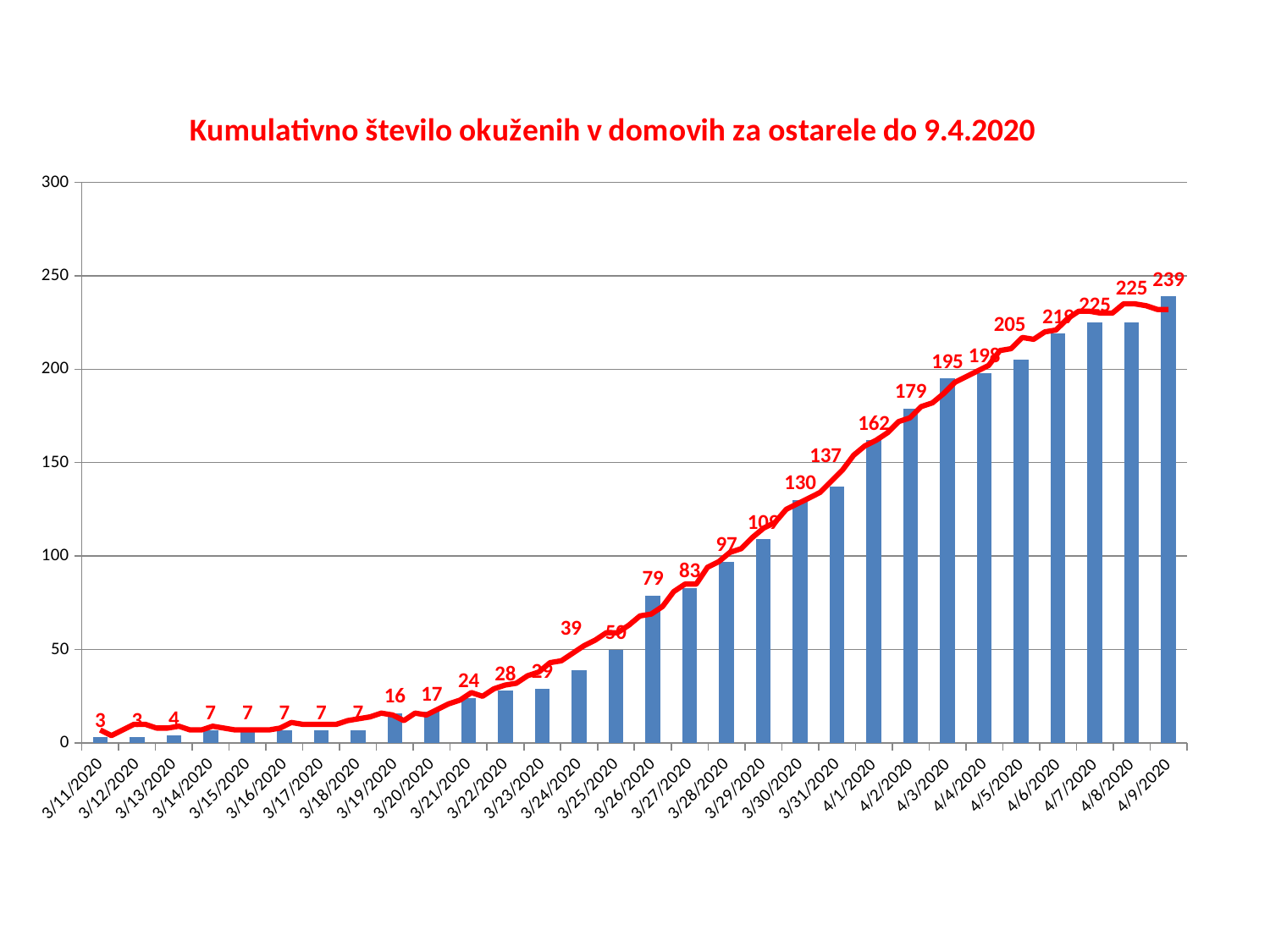
What value is shown for 3/19/2020? 16 What is the difference between the values for 4/9/2020 and 4/7/2020? 14 What value is shown for 3/26/2020? 79 Do the values generally rise or fall from 3/11/2020 to 4/9/2020? rise What is the difference between the values for 3/25/2020 and 3/24/2020? 11 Which date has the highest value in the chart? 4/9/2020 What value is shown for 4/5/2020? 205 Is the value for 3/29/2020 greater or less than 100? greater Which is larger, the value for 3/28/2020 or the value for 3/30/2020? 3/30/2020 How many dates are shown on the x axis? 30 What is the cumulative number of infected shown for 4/9/2020? 239 What kind of chart is this? bar chart with a line overlay